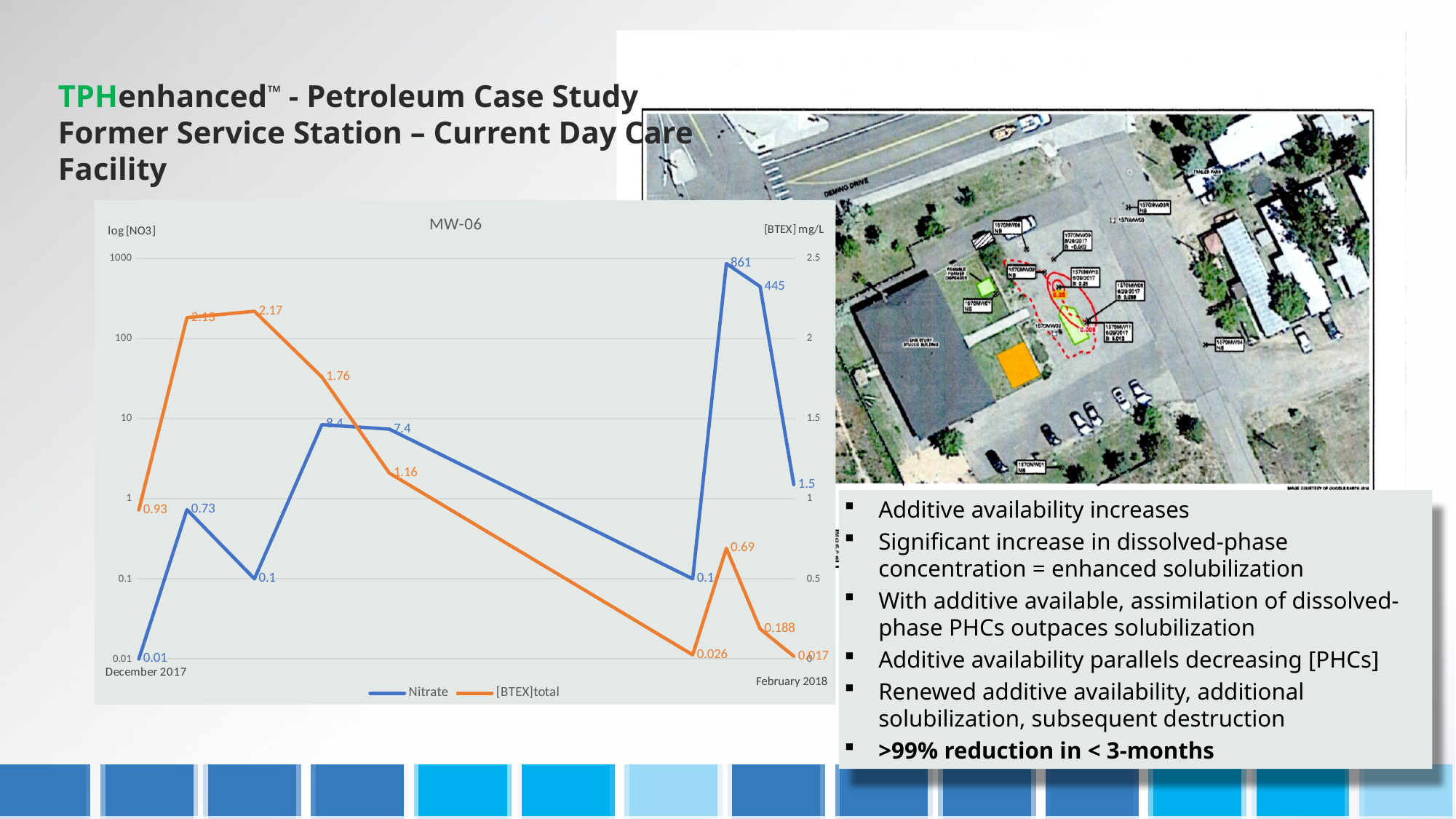
What is the lowest labelled value of the [BTEX]total series? 0.017 What is the first labelled value of the Nitrate series, at December 2017? 0.01 What is the title of the chart? MW-06 What is the highest labelled value of the [BTEX]total series? 2.17 How many series does the legend of the MW-06 chart list? 2 What is the difference between the two highest Nitrate values, 861 and 445? 416 What is the highest labelled value of the Nitrate series? 861 What kind of chart is shown on the slide? line chart Which is larger for the [BTEX]total series: the value 1.76 or the value 1.16? 1.76 What is the last labelled value of the [BTEX]total series, at February 2018? 0.017 What is the lowest labelled value of the Nitrate series? 0.01 How many labelled data points does the Nitrate series have? 9